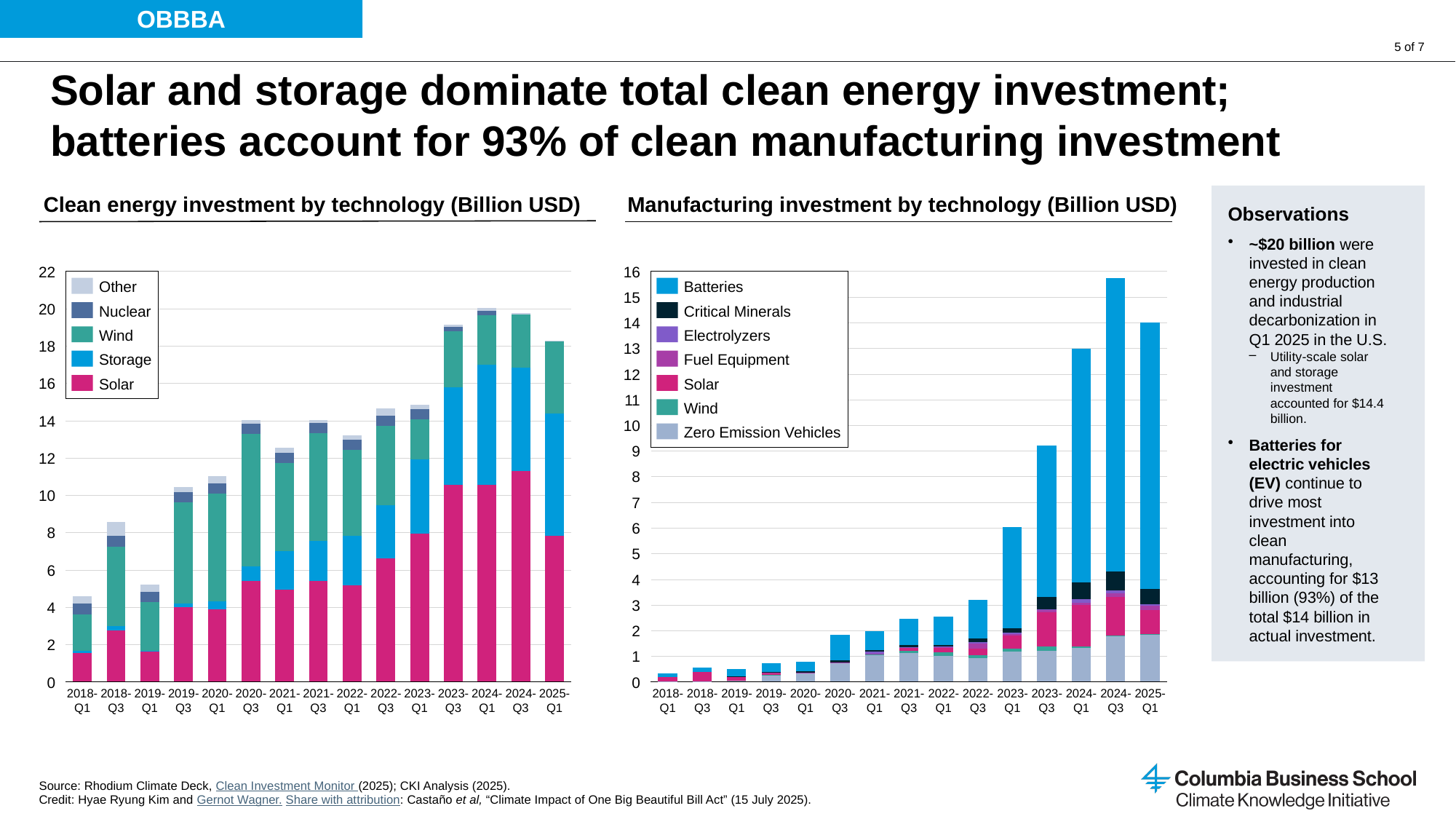
In the 'Manufacturing investment by technology (Billion USD)' chart, which series is listed first in the legend? Batteries In the 'Manufacturing investment by technology (Billion USD)' chart, which total bar is larger, 2024-Q3 or 2025-Q1? 2024-Q3 How many series does the legend of the 'Manufacturing investment by technology (Billion USD)' chart list? 7 In the 'Manufacturing investment by technology (Billion USD)' chart, which quarter has the highest total bar? 2024-Q3 What kind of chart is the 'Clean energy investment by technology (Billion USD)' chart? Stacked bar chart In the 'Clean energy investment by technology (Billion USD)' chart, is the total for 2018-Q1 greater or less than 6? less In the 'Manufacturing investment by technology (Billion USD)' chart, is the total for 2025-Q1 greater or less than 12? greater In the 'Manufacturing investment by technology (Billion USD)' chart, do the total bars generally rise or fall from 2018-Q1 to 2024-Q3? Rise How many series does the legend of the 'Clean energy investment by technology (Billion USD)' chart list? 5 How many quarters are shown on the x axis of the 'Manufacturing investment by technology (Billion USD)' chart? 15 In the 'Clean energy investment by technology (Billion USD)' chart, is the total for 2023-Q3 greater or less than 18? greater In the 'Clean energy investment by technology (Billion USD)' chart, which quarter has the lowest total bar? 2018-Q1